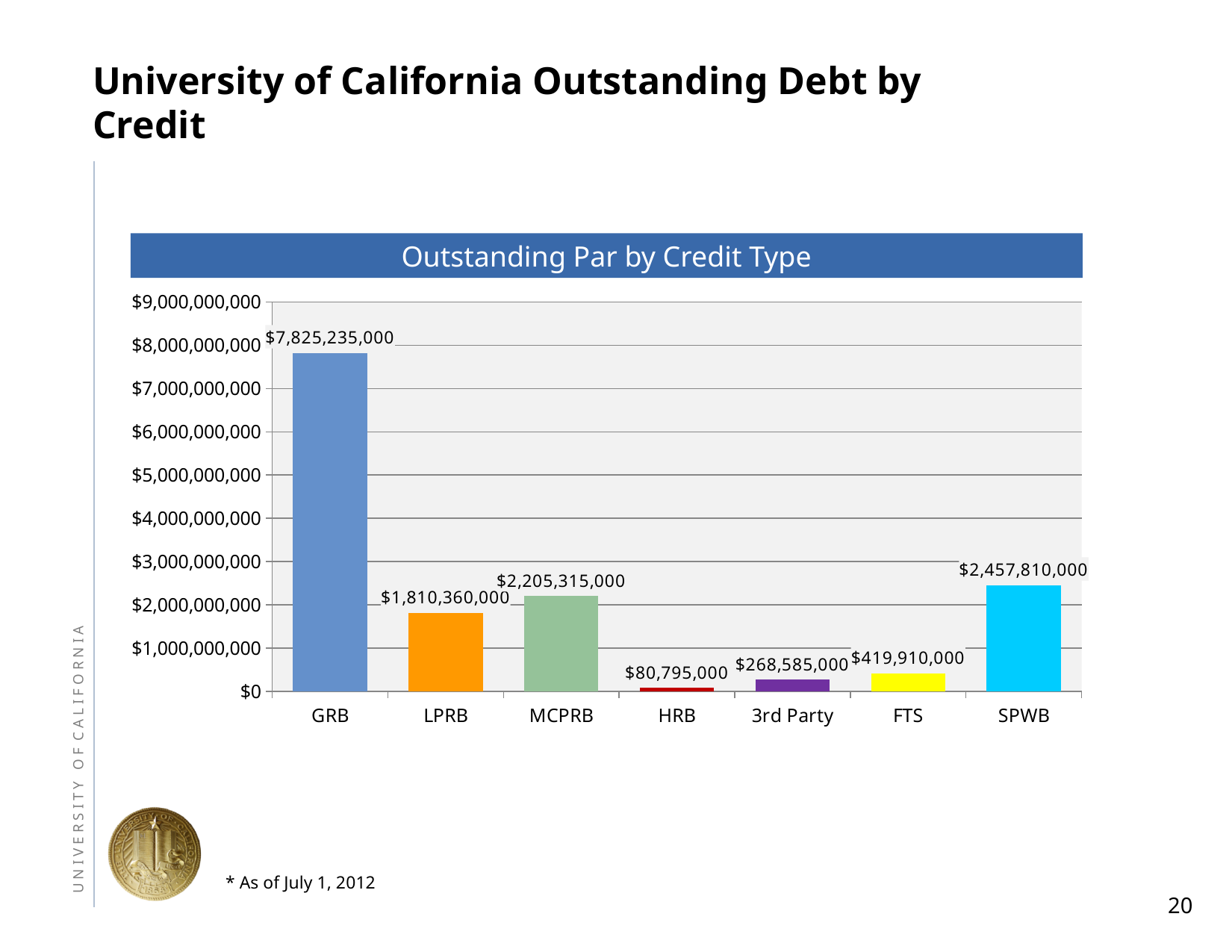
How many credit types are shown in the chart? 7 Which credit type has the lowest outstanding par? HRB What is the outstanding par for 3rd Party? $268,585,000 Which credit type has the highest outstanding par? GRB What kind of chart is shown on the slide? Bar chart Which has a larger outstanding par, LPRB or MCPRB? MCPRB What is the outstanding par for HRB? $80,795,000 What is the difference between the outstanding par for SPWB and MCPRB? $252,495,000 What is the title of the chart? Outstanding Par by Credit Type What is the outstanding par for GRB? $7,825,235,000 What is the difference between the outstanding par for FTS and 3rd Party? $151,325,000 What is the outstanding par for SPWB? $2,457,810,000